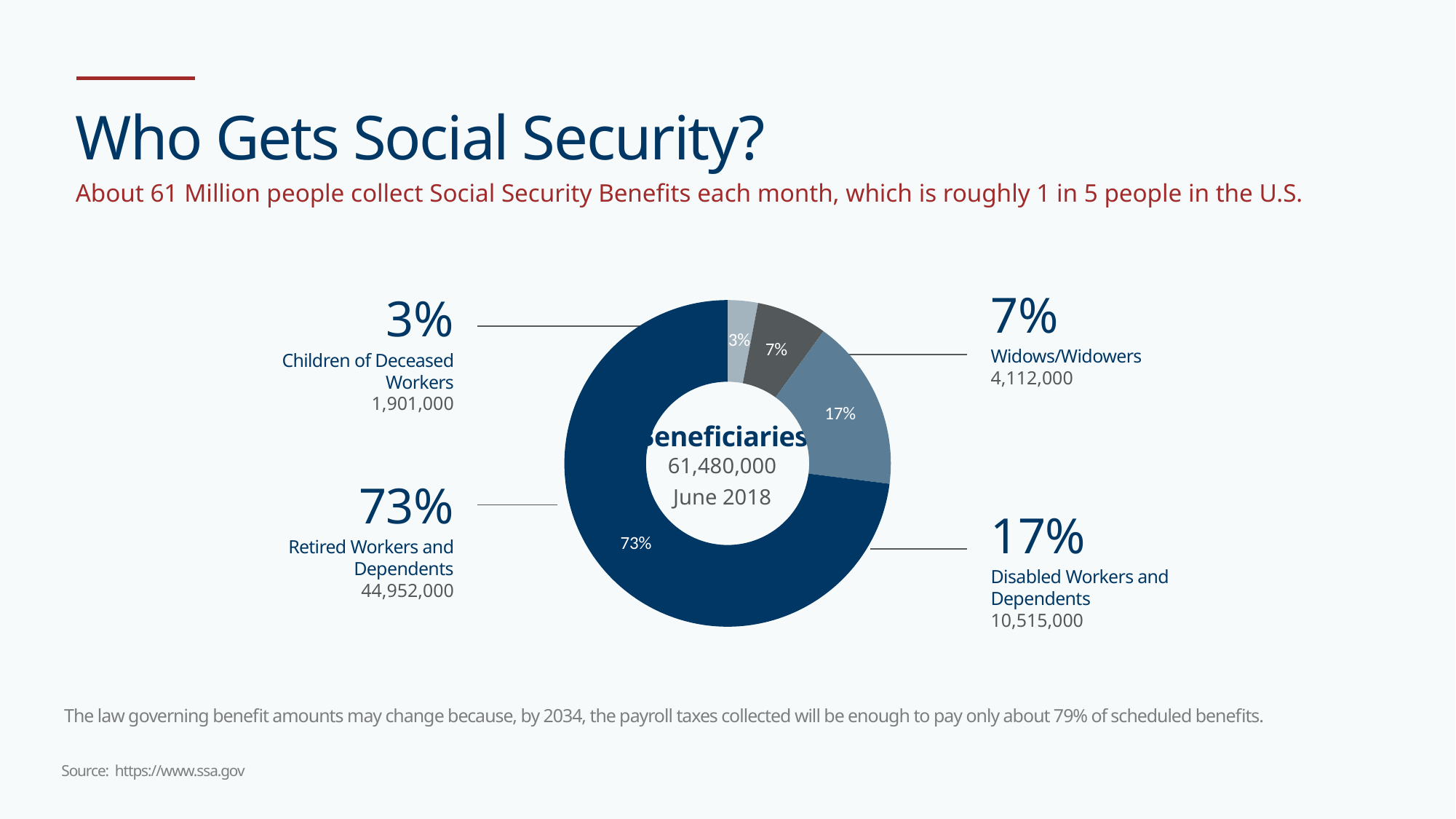
What kind of chart is shown on the slide? Pie chart (donut) What share of beneficiaries are Widows/Widowers? 7% Which is larger: the share for Widows/Widowers or the share for Children of Deceased Workers? Widows/Widowers What is the difference in percentage points between Disabled Workers and Dependents and Widows/Widowers? 10 percentage points What total number of beneficiaries is shown in the centre of the chart? 61,480,000 How many beneficiaries are Disabled Workers and Dependents? 10,515,000 How many beneficiaries are Children of Deceased Workers? 1,901,000 What share of beneficiaries are Retired Workers and Dependents? 73% How many beneficiaries are Widows/Widowers? 4,112,000 How many categories does the chart show? 4 Which category has the largest share of beneficiaries? Retired Workers and Dependents Which category has the smallest share of beneficiaries? Children of Deceased Workers